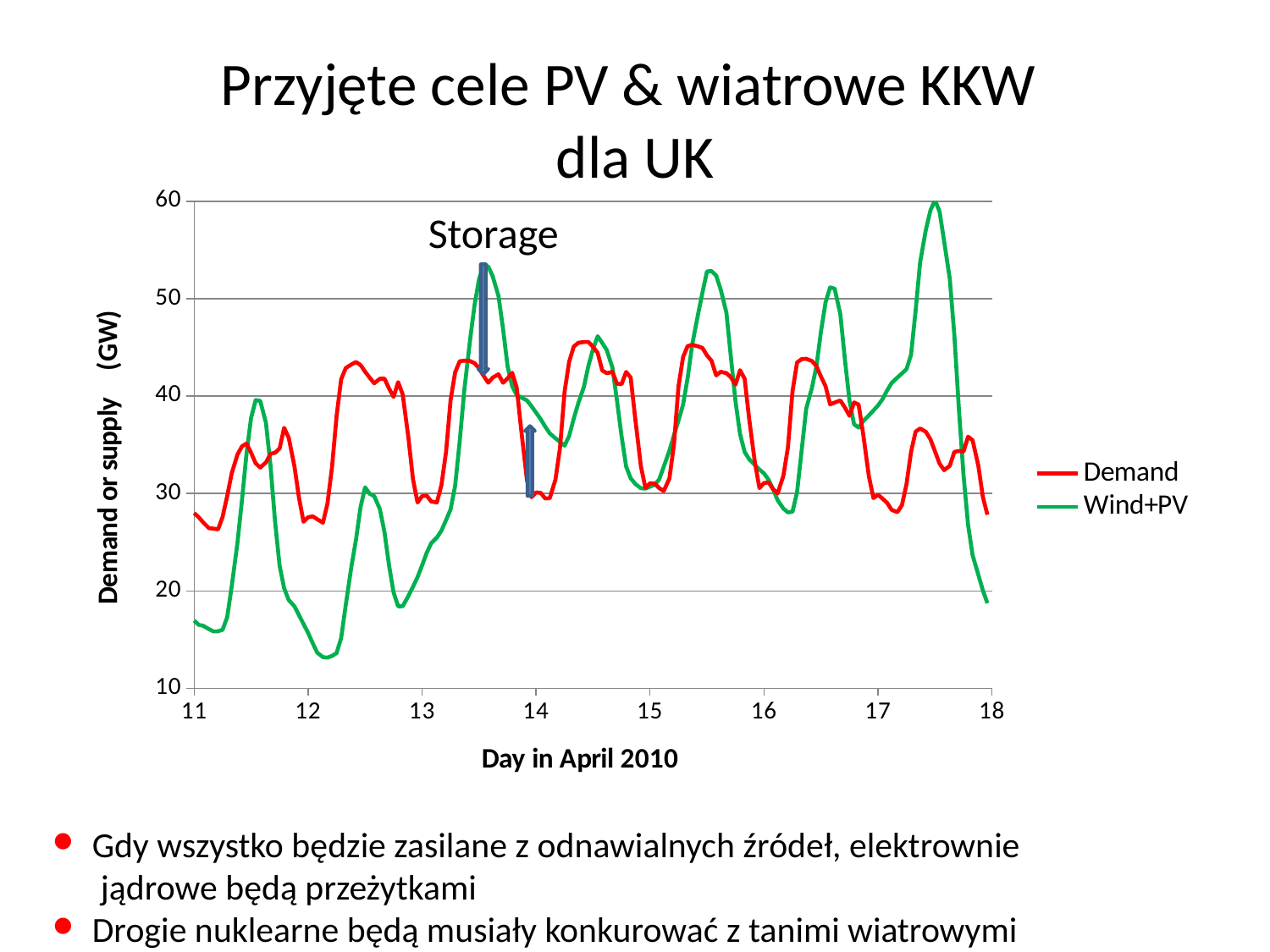
Is the Wind+PV value at day 17.5 greater or less than 50? greater Is the Demand value at day 12 greater or less than 30? less Does the Wind+PV line rise or fall between day 17.5 and day 18? fall How many series does the chart's legend list? 2 Is the Demand value at day 15.5 greater or less than 40? greater What is the title of the chart's x axis? Day in April 2010 What are the two series named in the chart's legend? Demand and Wind+PV At day 12, which series has the larger value, Demand or Wind+PV? Demand At day 13.5, which series has the larger value, Demand or Wind+PV? Wind+PV What kind of chart is shown on the slide? line chart At day 17.5, which series has the larger value, Demand or Wind+PV? Wind+PV